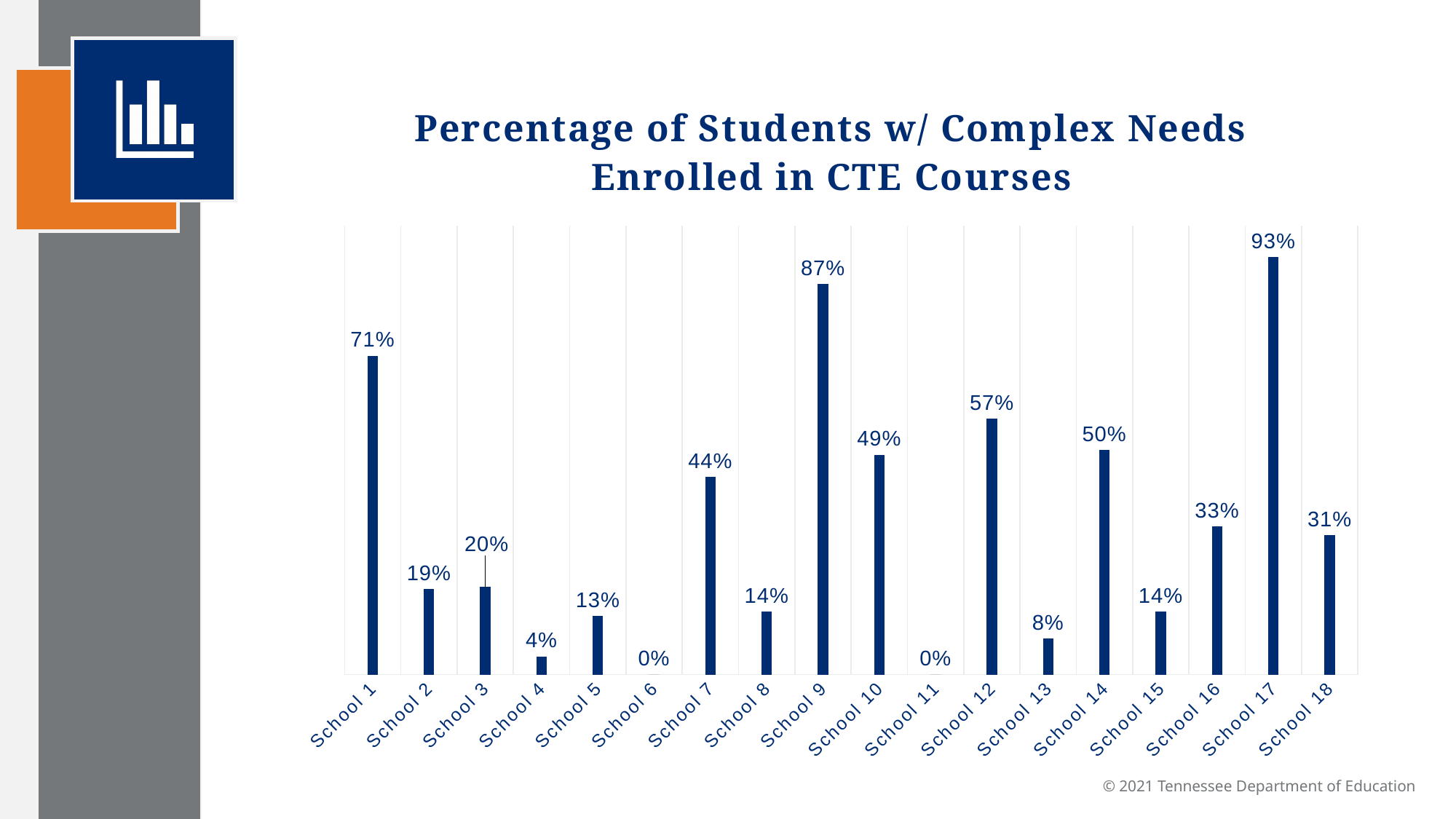
What is the value for School 4? 4% What is the value for School 9? 87% What is the difference between the values for School 12 and School 10? 8% What kind of chart is shown on the slide? Bar chart Which is larger, the value for School 16 or the value for School 18? School 16 How many schools are shown on the chart? 18 Which school has the highest percentage of students with complex needs enrolled in CTE courses? School 17 What is the title of the chart? Percentage of Students w/ Complex Needs Enrolled in CTE Courses What is the difference between the values for School 17 and School 9? 6% Which is larger, the value for School 1 or the value for School 12? School 1 What is the value for School 14? 50% Which schools have the lowest value on the chart? School 6 and School 11